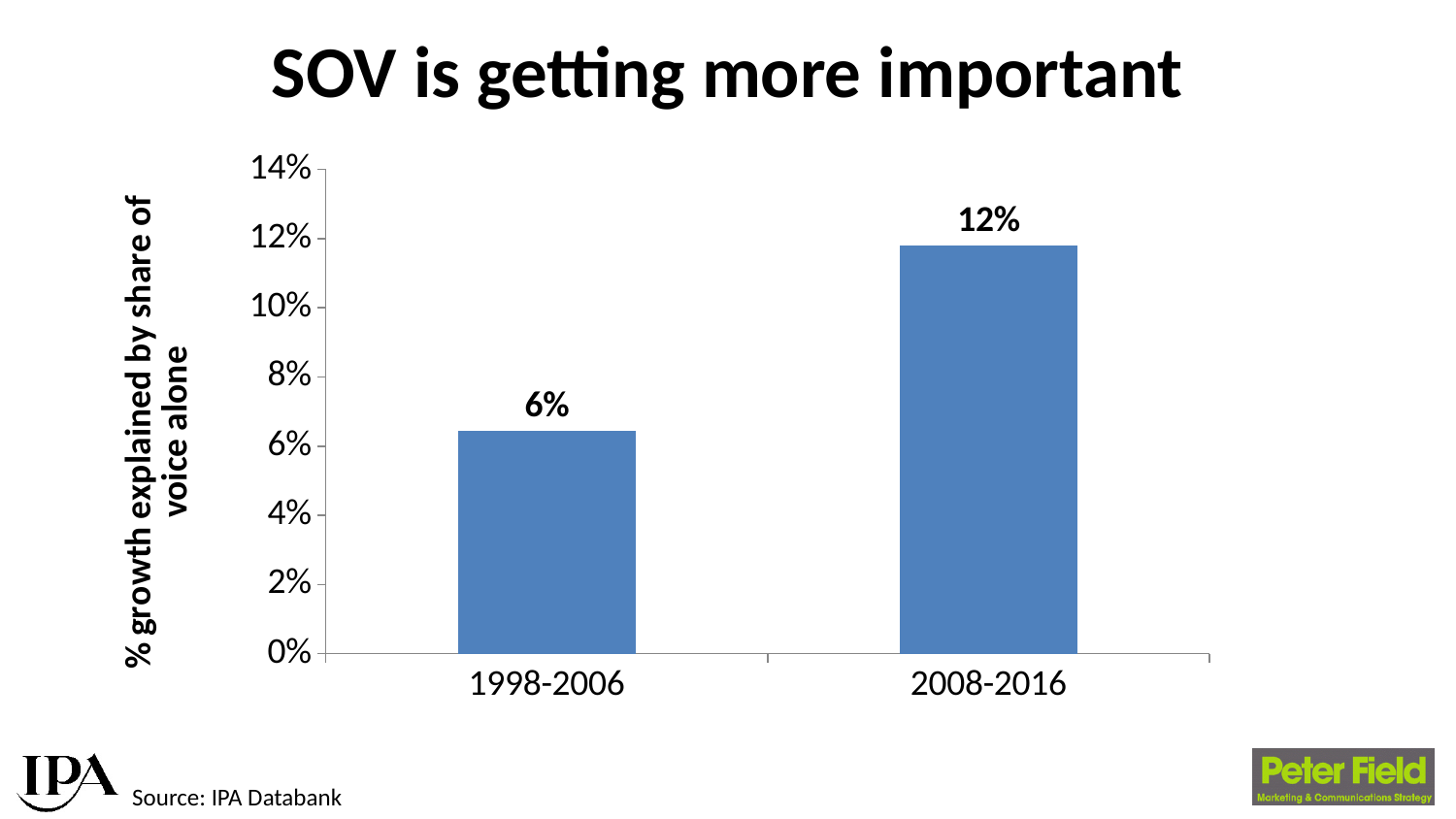
Is the value for 1998-2006 greater or less than 8%? less What is the value for 1998-2006? 6% What kind of chart is shown on the slide? Bar chart Is the value for 2008-2016 greater or less than 10%? greater Do the values rise or fall from 1998-2006 to 2008-2016? Rise What is the value for 2008-2016? 12% How many periods are shown on the chart? 2 What is the title of the slide? SOV is getting more important Which is larger, the value for 1998-2006 or the value for 2008-2016? 2008-2016 Which period has the highest value? 2008-2016 What is the difference between the values for 2008-2016 and 1998-2006? 6% Which period has the lowest value? 1998-2006